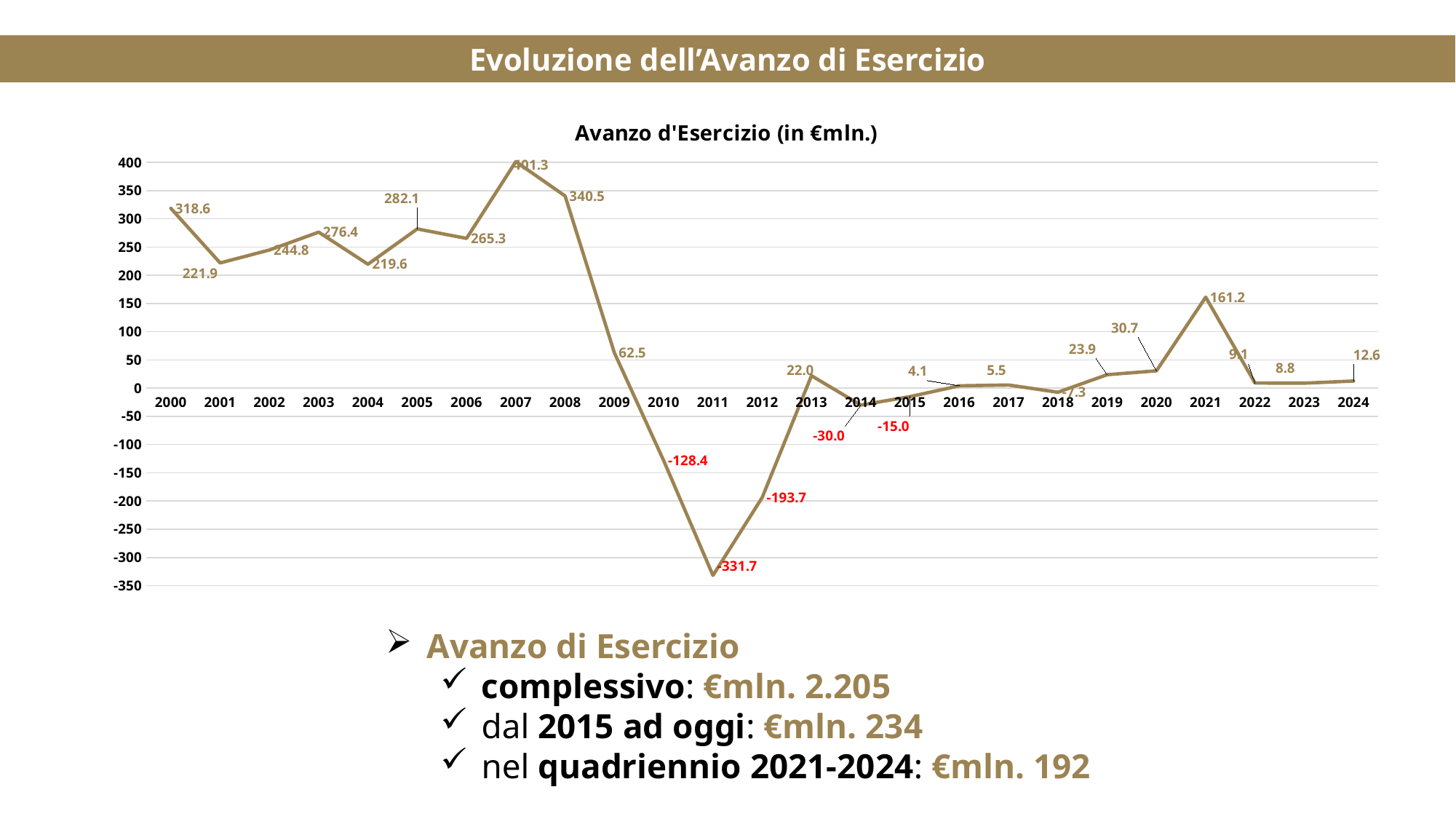
What is the value for 2021 in the Avanzo d'Esercizio chart? 161.2 What is the difference between the values for 2008 and 2009? 278.0 Do the values rise or fall from 2021 to 2022? fall Which year has the larger value, 2005 or 2006? 2005 What is the title of the chart? Avanzo d'Esercizio (in €mln.) What is the value for 2000 in the Avanzo d'Esercizio chart? 318.6 What type of chart is shown on the slide? line chart What is the value for 2024 in the Avanzo d'Esercizio chart? 12.6 What is the value for 2011 in the Avanzo d'Esercizio chart? -331.7 How many years are plotted in the Avanzo d'Esercizio chart? 25 Which year has the lowest value in the Avanzo d'Esercizio chart? 2011 Which year has the highest value in the Avanzo d'Esercizio chart? 2007